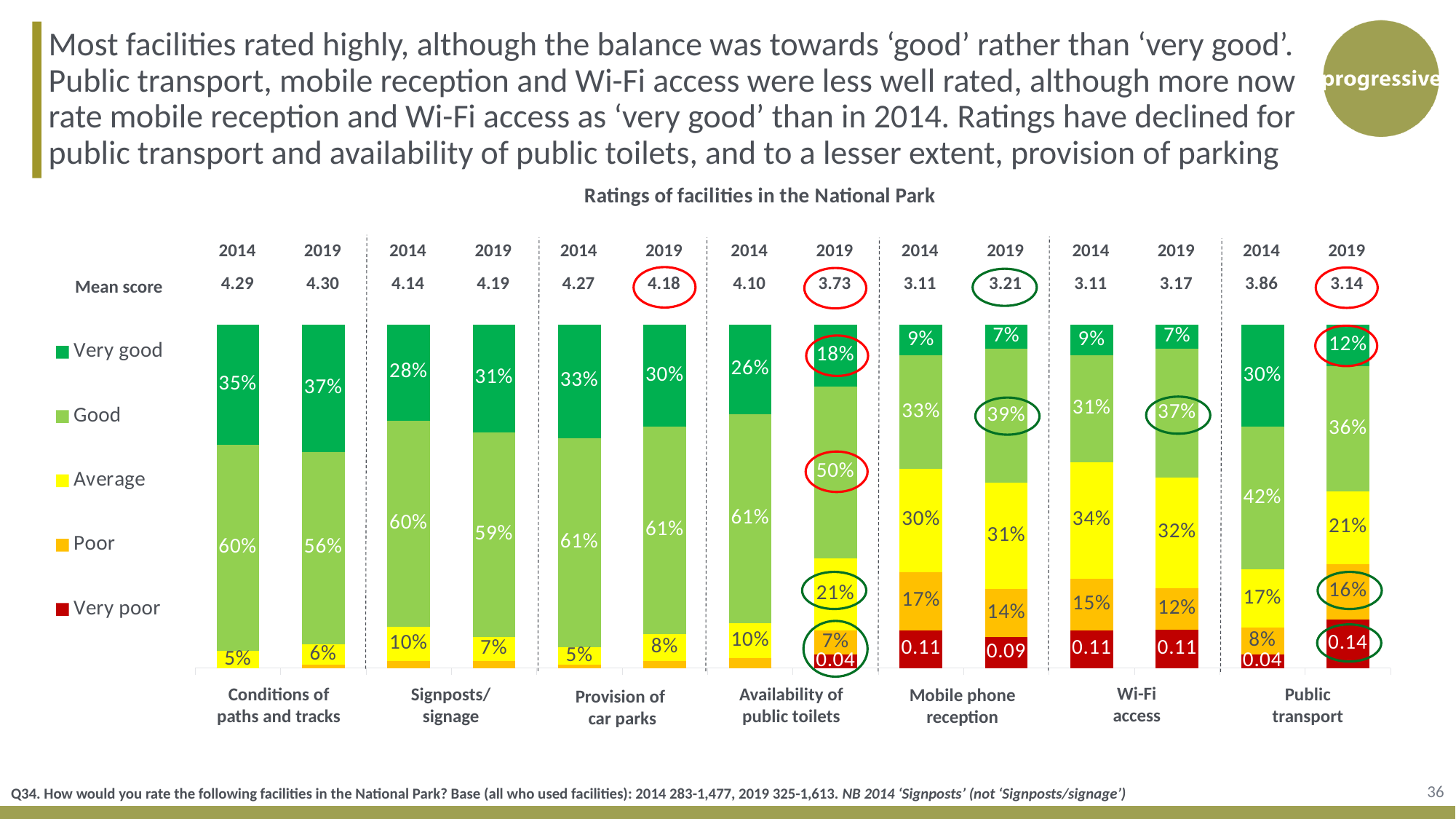
Which is larger: the 'Good' percentage for mobile phone reception in 2019 or for Wi-Fi access in 2019? Mobile phone reception in 2019 What percentage rated the conditions of paths and tracks as 'Very good' in 2019? 37% How many rating categories does the legend list? 5 What percentage rated Wi-Fi access as 'Average' in 2019? 32% What type of chart is shown on the slide? Stacked bar chart Which facility has the highest mean score in 2019? Conditions of paths and tracks What is the 'Poor' percentage for mobile phone reception in 2014? 17% By how many percentage points did the 'Very good' rating for public transport fall from 2014 to 2019? 18 What percentage rated public transport as 'Good' in 2014? 42% What is the mean score for availability of public toilets in 2019? 3.73 Which facility has the lowest mean score in 2019? Public transport How many facilities are shown on the chart? 7